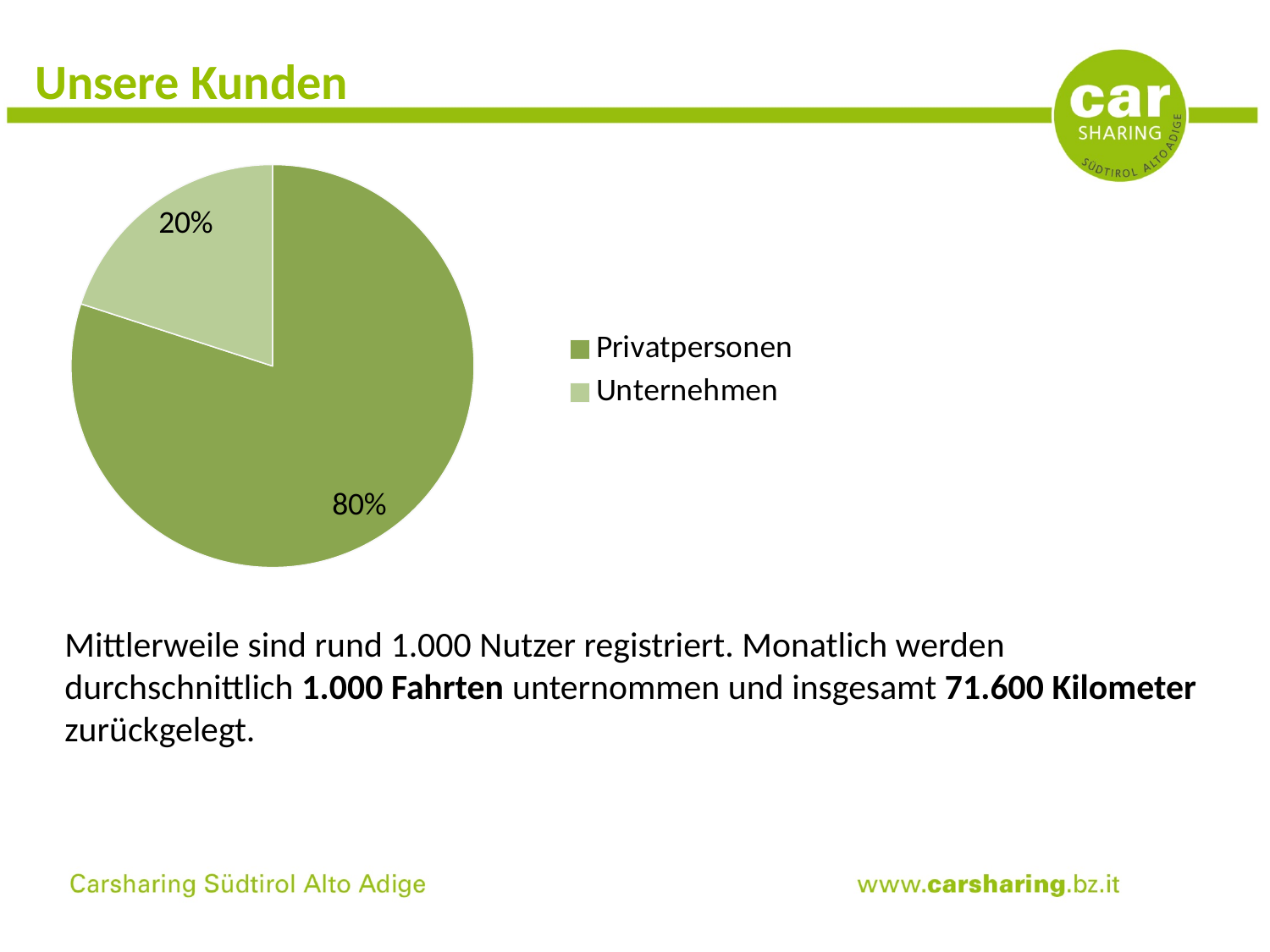
How many categories does the pie chart show? 2 Which legend entry is shown in the lighter green colour? Unternehmen Which is larger, the slice for Privatpersonen or the slice for Unternehmen? Privatpersonen Which category has the largest slice of the pie? Privatpersonen What is the difference in percentage points between Privatpersonen and Unternehmen? 60 How many entries does the legend list? 2 Which category has the smallest slice of the pie? Unternehmen What kind of chart is shown on the slide? pie chart What share of the pie does Unternehmen have? 20% What share of the pie does Privatpersonen have? 80% What is the title of the slide containing the pie chart? Unsere Kunden